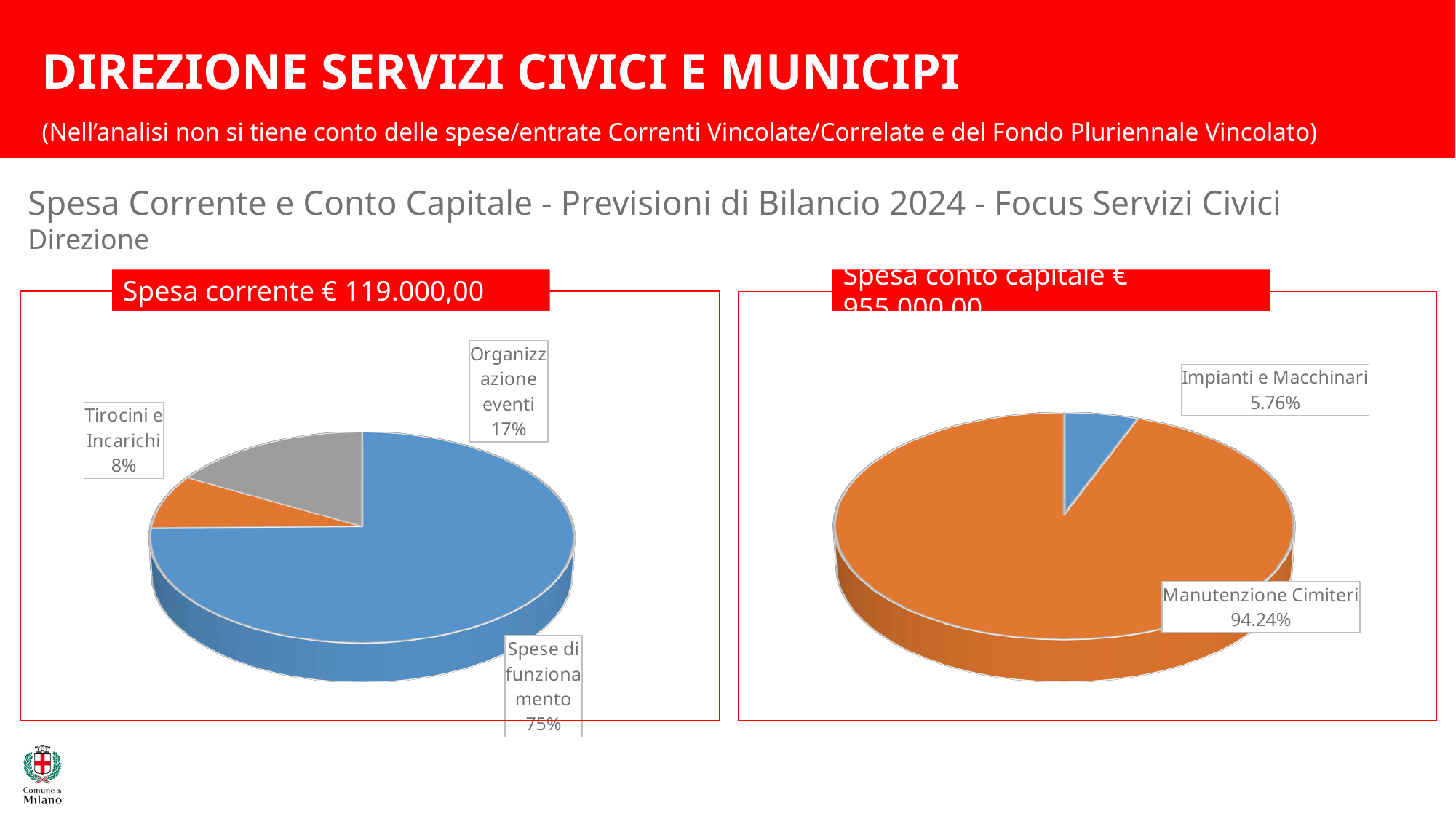
What total amount is shown in the red label above the left pie chart? € 119.000,00 In the 'Spesa corrente' pie chart on the left, which slice is the largest? Spese di funzionamento In the 'Spesa corrente' pie chart on the left, how many slices are there? 3 In the 'Spesa conto capitale' pie chart on the right, what share does 'Manutenzione Cimiteri' have? 94.24% In the 'Spesa corrente' pie chart on the left, which slice is the smallest? Tirocini e Incarichi In the 'Spesa corrente' pie chart on the left, what share does 'Organizzazione eventi' have? 17% In the 'Spesa conto capitale' pie chart on the right, what share does 'Impianti e Macchinari' have? 5.76% What type of chart is shown on the right side of the slide? Pie chart In the 'Spesa corrente' pie chart on the left, what is the difference in percentage points between 'Organizzazione eventi' and 'Tirocini e Incarichi'? 9 percentage points In the 'Spesa conto capitale' pie chart on the right, which slice is larger, 'Manutenzione Cimiteri' or 'Impianti e Macchinari'? Manutenzione Cimiteri